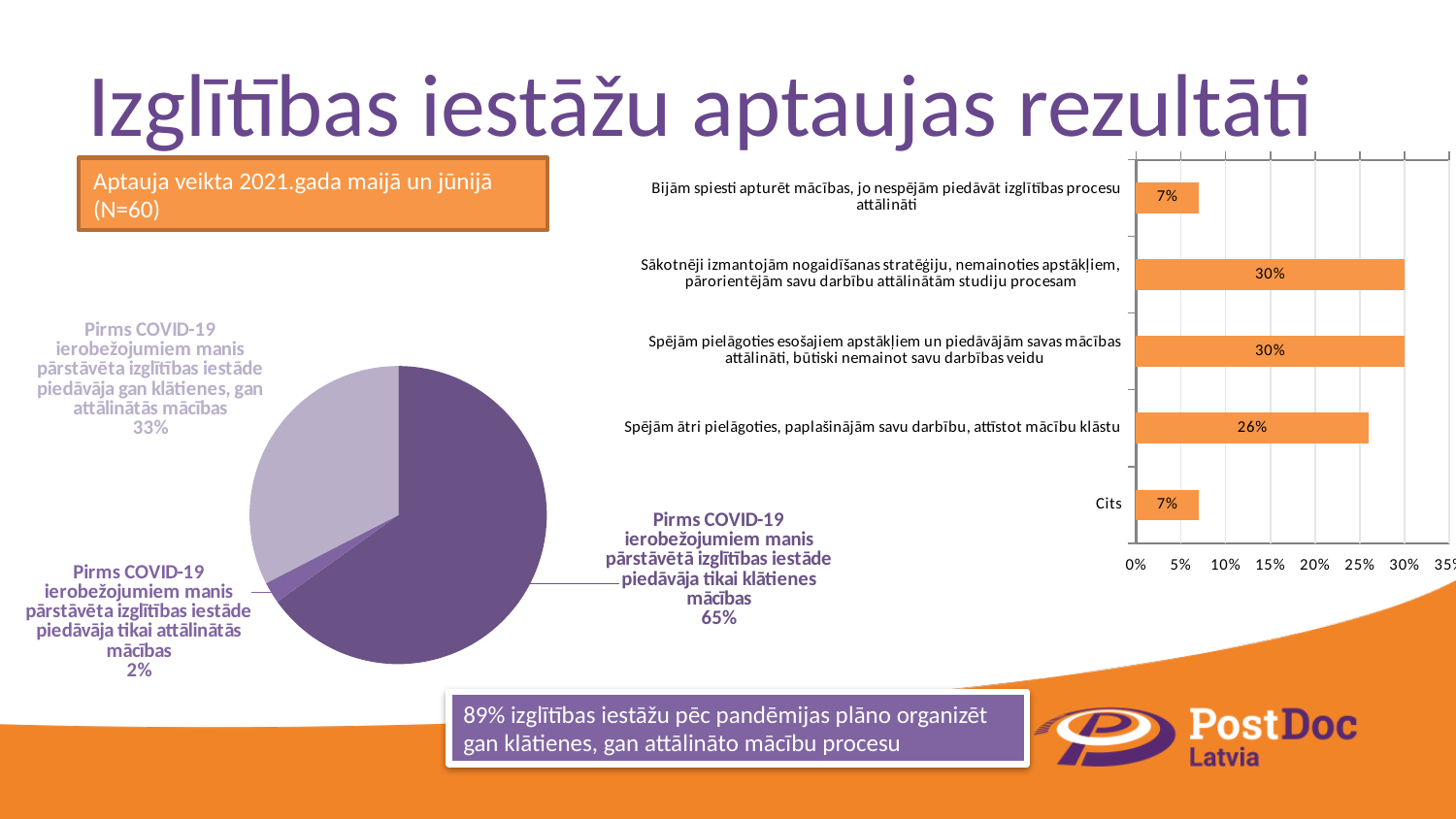
In the bar chart on the right, what is the value for 'Spējām ātri pielāgoties, paplašinājām savu darbību, attīstot mācību klāstu'? 26% In the pie chart on the left, what share is shown for 'Pirms COVID-19 ierobežojumiem manis pārstāvēta izglītības iestāde piedāvāja gan klātienes, gan attālinātās mācības'? 33% In the pie chart on the left, which slice is the smallest? Pirms COVID-19 ierobežojumiem manis pārstāvēta izglītības iestāde piedāvāja tikai attālinātās mācības (2%) How many categories does the bar chart on the right show? 5 In the pie chart on the left, what share is shown for 'Pirms COVID-19 ierobežojumiem manis pārstāvētā izglītības iestāde piedāvāja tikai klātienes mācības'? 65% What kind of chart is the chart on the left of the slide? pie chart In the bar chart on the right, which is larger: the value for 'Sākotnēji izmantojām nogaidīšanas stratēģiju, nemainoties apstākļiem, pārorientējām savu darbību attālinātām studiju procesam' or the value for 'Spējām ātri pielāgoties, paplašinājām savu darbību, attīstot mācību klāstu'? Sākotnēji izmantojām nogaidīšanas stratēģiju, nemainoties apstākļiem, pārorientējām savu darbību attālinātām studiju procesam In the bar chart on the right, what is the value for 'Bijām spiesti apturēt mācības, jo nespējām piedāvāt izglītības procesu attālināti'? 7% In the bar chart on the right, what is the difference between the value for 'Spējām pielāgoties esošajiem apstākļiem un piedāvājām savas mācības attālināti, būtiski nemainot savu darbības veidu' and the value for 'Cits'? 23% How many slices does the pie chart on the left have? 3 What kind of chart is the chart on the right of the slide? bar chart In the bar chart on the right, what is the value for 'Cits'? 7%